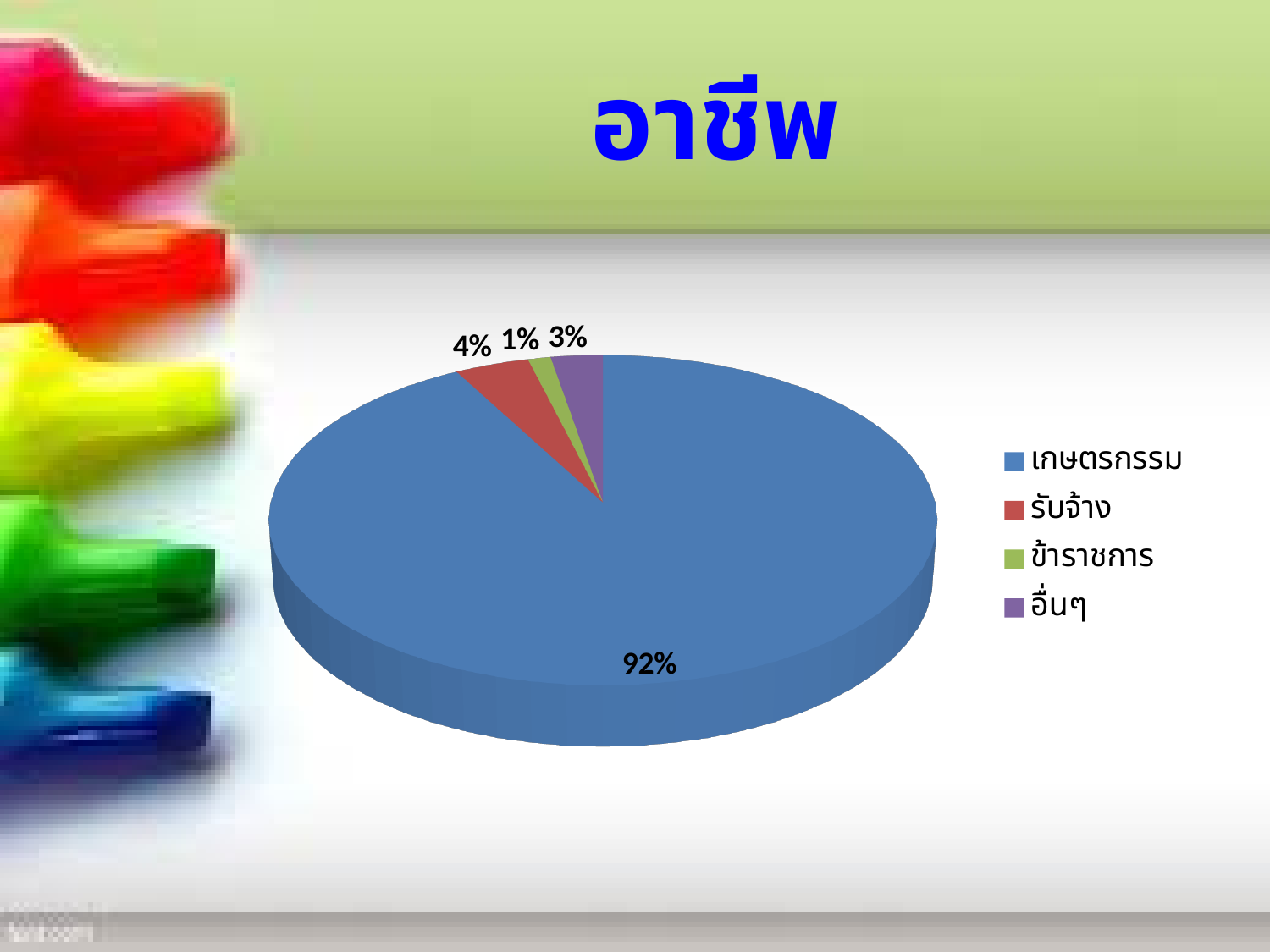
What share of the pie does อื่นๆ take? 3% What share of the pie does ข้าราชการ take? 1% Which category has the largest slice of the pie? เกษตรกรรม What share of the pie does เกษตรกรรม take? 92% What colour is the slice for อื่นๆ? Purple What is the difference in percentage points between เกษตรกรรม and รับจ้าง? 88 What is the title of the chart? อาชีพ How many categories does the pie chart show? 4 What kind of chart is shown on the slide? Pie chart Which is larger, the share for รับจ้าง or the share for อื่นๆ? รับจ้าง Which category has the smallest slice of the pie? ข้าราชการ